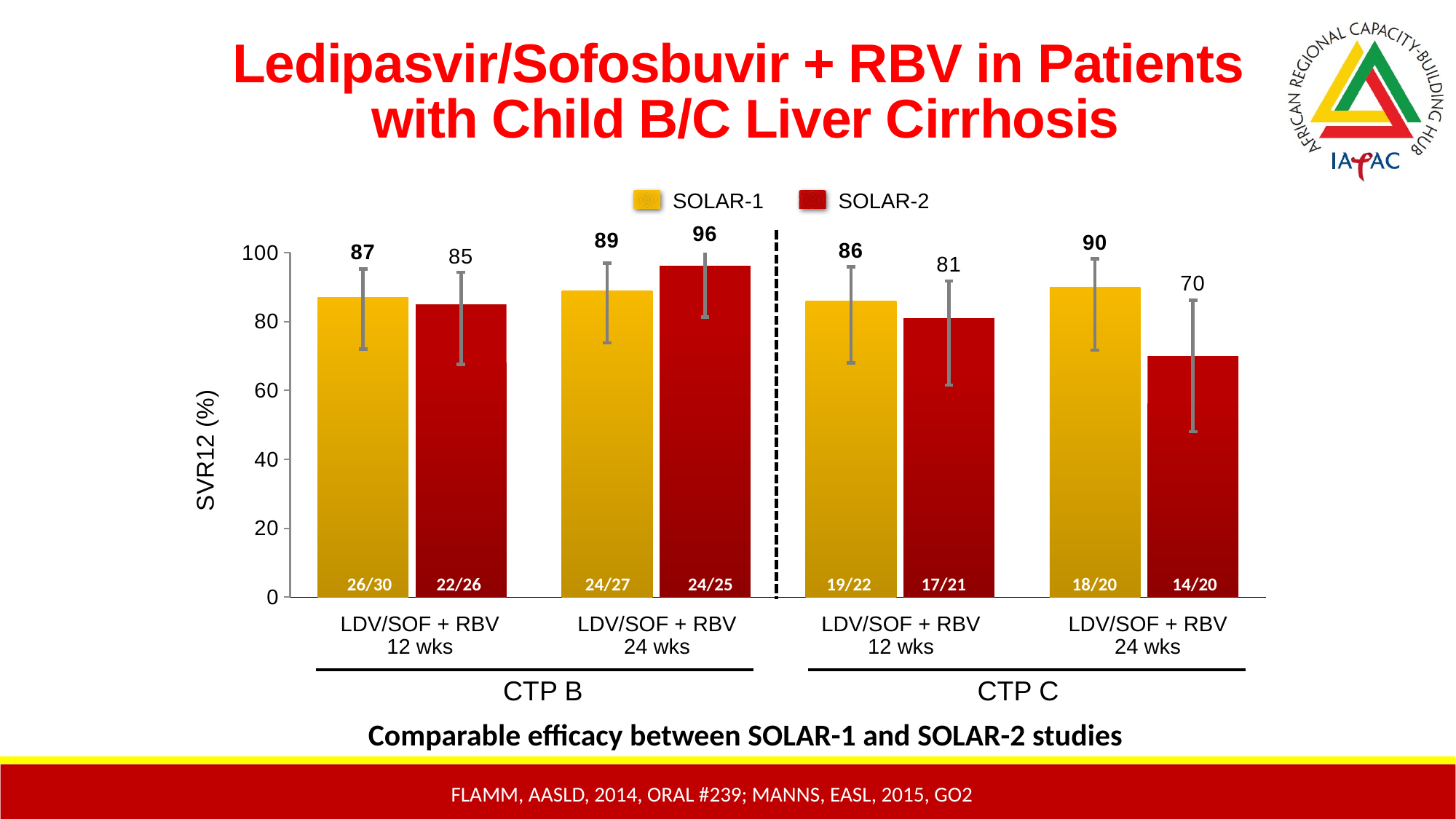
What is the difference between the SOLAR-1 and SOLAR-2 SVR12 values in the CTP C LDV/SOF + RBV 24 wks group? 20 What is the label of the y axis? SVR12 (%) What is the SVR12 value for SOLAR-2 in the CTP B LDV/SOF + RBV 24 wks group? 96 Which bar has the highest SVR12 value on the chart? SOLAR-2, CTP B LDV/SOF + RBV 24 wks Which bar has the lowest SVR12 value on the chart? SOLAR-2, CTP C LDV/SOF + RBV 24 wks What fraction of patients is printed on the SOLAR-1 bar for CTP C LDV/SOF + RBV 12 wks? 19/22 Is the SOLAR-2 SVR12 value for CTP C LDV/SOF + RBV 12 wks greater or less than 80? greater What kind of chart is shown on the slide? Bar chart What is the SVR12 value for SOLAR-1 in the CTP B LDV/SOF + RBV 12 wks group? 87 What is the SVR12 value for SOLAR-2 in the CTP C LDV/SOF + RBV 24 wks group? 70 In the CTP B LDV/SOF + RBV 24 wks group, which study has the higher SVR12 value, SOLAR-1 or SOLAR-2? SOLAR-2 How many series does the legend list? 2